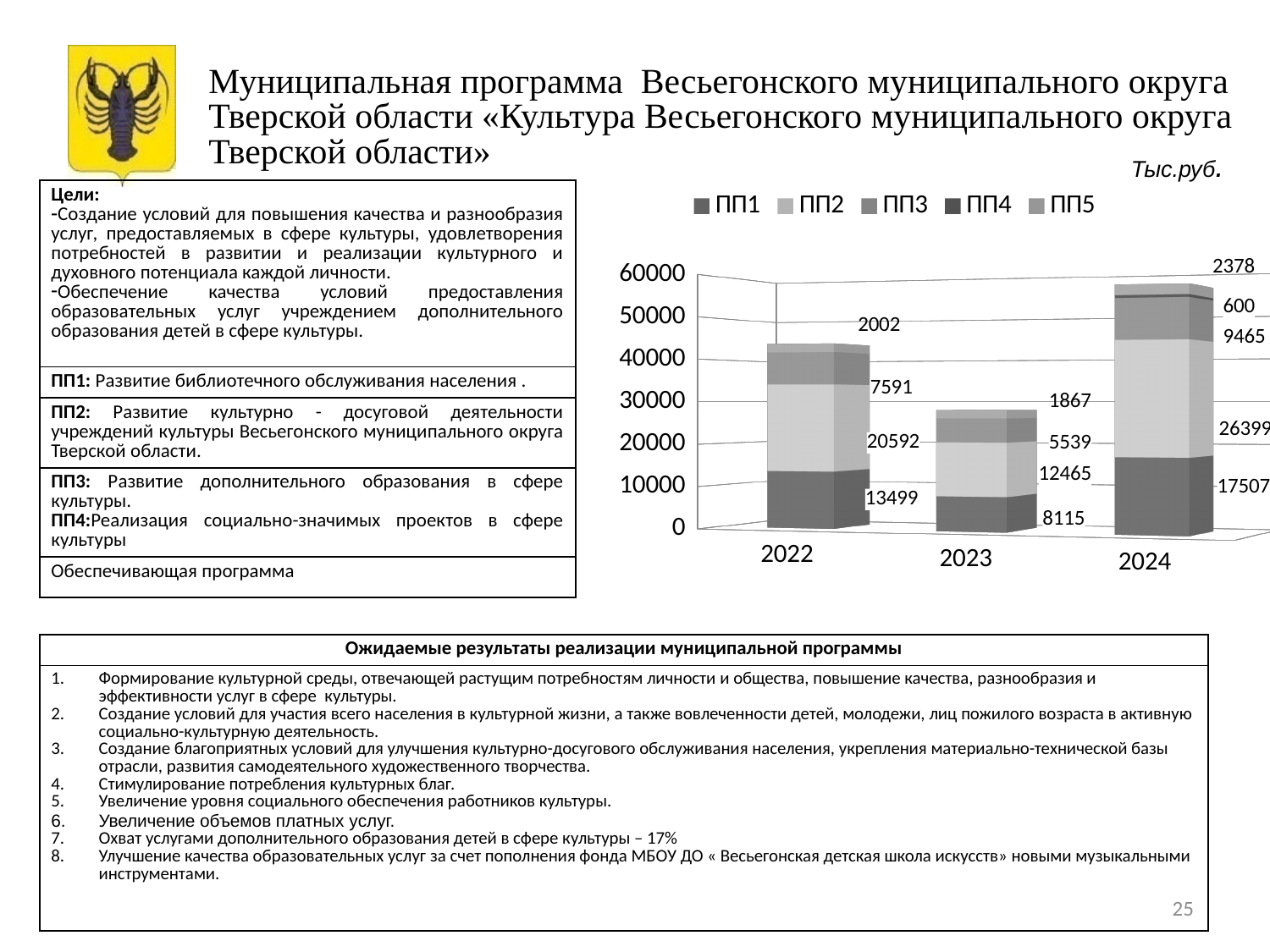
What is the value of ПП2 in 2022? 20592 What is the value of ПП1 in 2023? 8115 What kind of chart is shown on the slide? Stacked bar chart Which year has the shortest stacked bar? 2023 How many years are shown on the x axis of the chart? 3 Which year has the tallest stacked bar? 2024 By how much does ПП1 in 2024 exceed ПП1 in 2022? 4008 How many series does the chart legend list? 5 Which year has the larger value for ПП2, 2023 or 2024? 2024 What is the value of ПП3 in 2024? 9465 What is the value of ПП5 in 2024? 2378